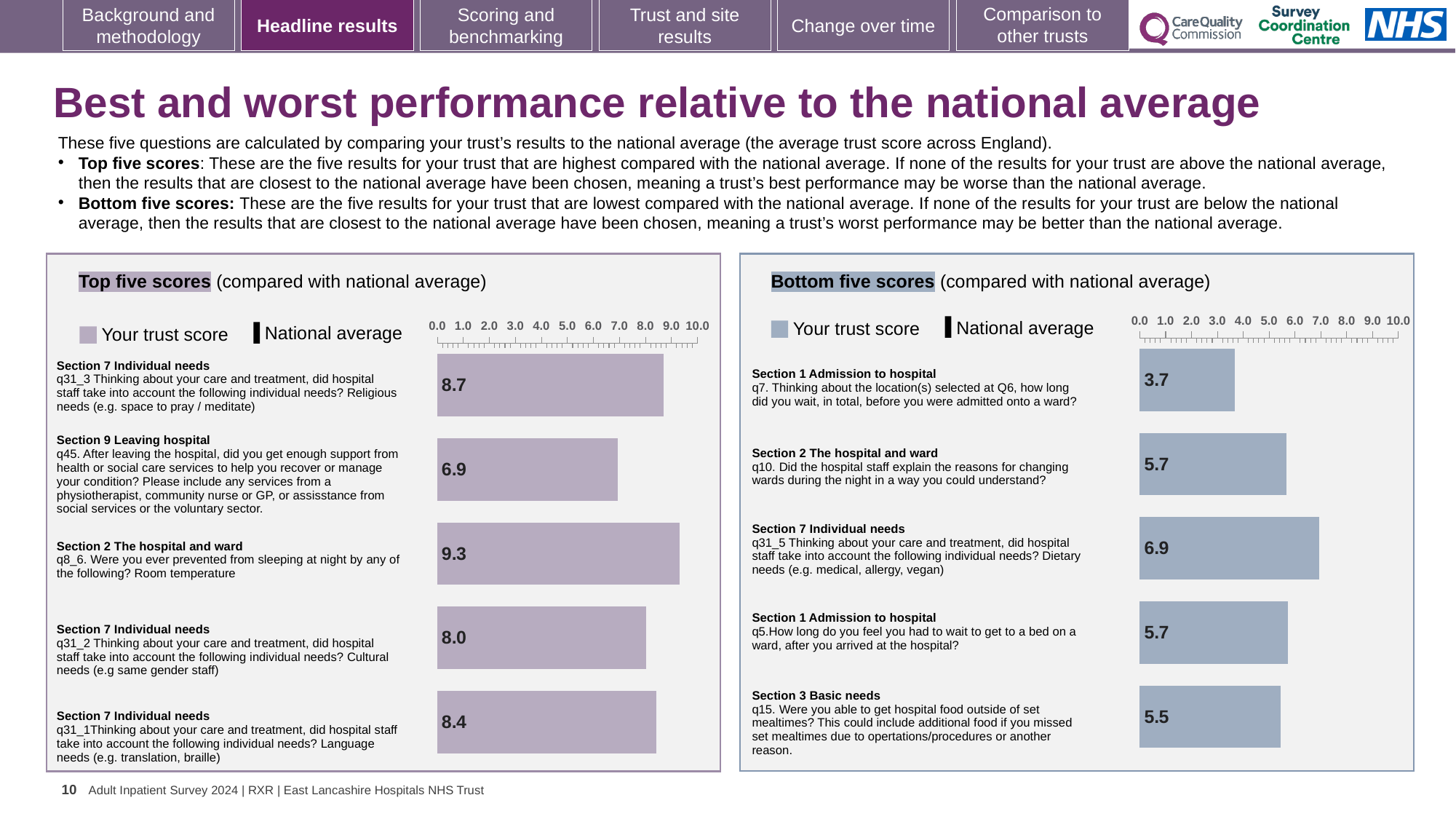
In the Top five scores chart, what is the trust score for q31_2 (cultural needs)? 8.0 In the Bottom five scores chart, what is the difference between the trust scores for q31_5 (dietary needs) and q7 (wait before admission to a ward)? 3.2 In the Top five scores chart, what is the trust score for q8_6 (prevented from sleeping at night by room temperature)? 9.3 How many bars are shown in the Bottom five scores chart? 5 In the Bottom five scores chart, which question has the highest trust score? q31_5 Dietary needs (6.9) In the Top five scores chart, which question has the lowest trust score? q45 Support after leaving hospital (6.9) In the Top five scores chart, what is the difference between the trust scores for q8_6 (room temperature) and q45 (support after leaving hospital)? 2.4 In the Bottom five scores chart, which question has the lowest trust score? q7 Wait before being admitted onto a ward (3.7) In the Top five scores chart, which has the higher trust score: q31_3 (religious needs) or q31_1 (language needs)? q31_3 Religious needs In the Bottom five scores chart, what is the trust score for q7 (how long did you wait before being admitted onto a ward)? 3.7 What type of chart is used for the Top five scores? Bar chart In the Top five scores chart, which question has the highest trust score? q8_6 Room temperature (9.3)